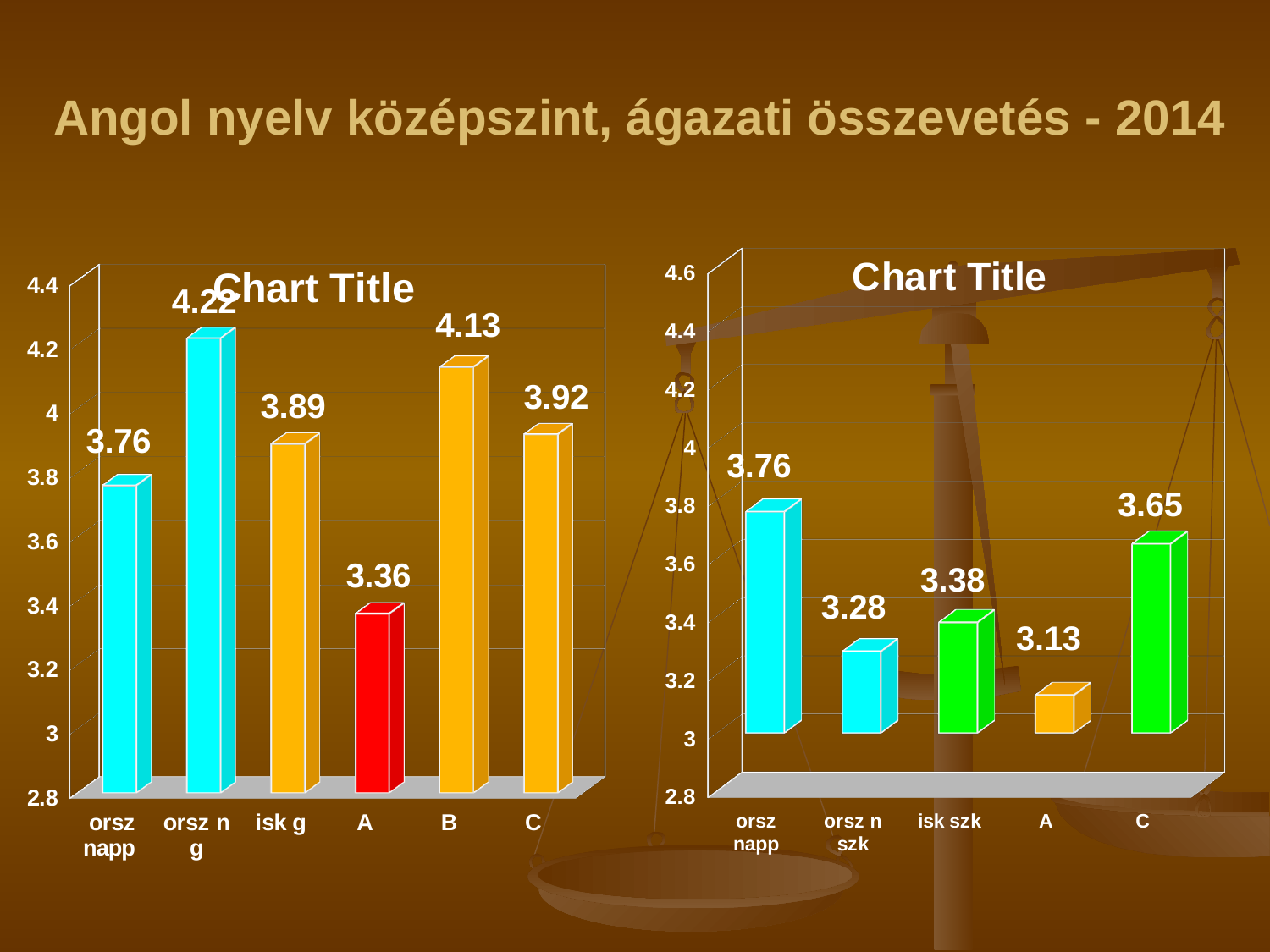
In the right chart, what is the value for orsz n szk? 3.28 In the left chart, which category has the highest value? orsz n g In the right chart, what is the value for C? 3.65 In the right chart, which is larger, the value for isk szk or the value for C? C In the left chart, which category has the lowest value? A In the left chart, what is the value for isk g? 3.89 What kind of chart is the left chart? bar chart In the left chart, what is the difference between the values for orsz n g and A? 0.86 In the right chart, which category has the lowest value? A In the right chart, which category has the highest value? orsz napp How many categories are shown in the right chart? 5 In the left chart, what is the value for B? 4.13